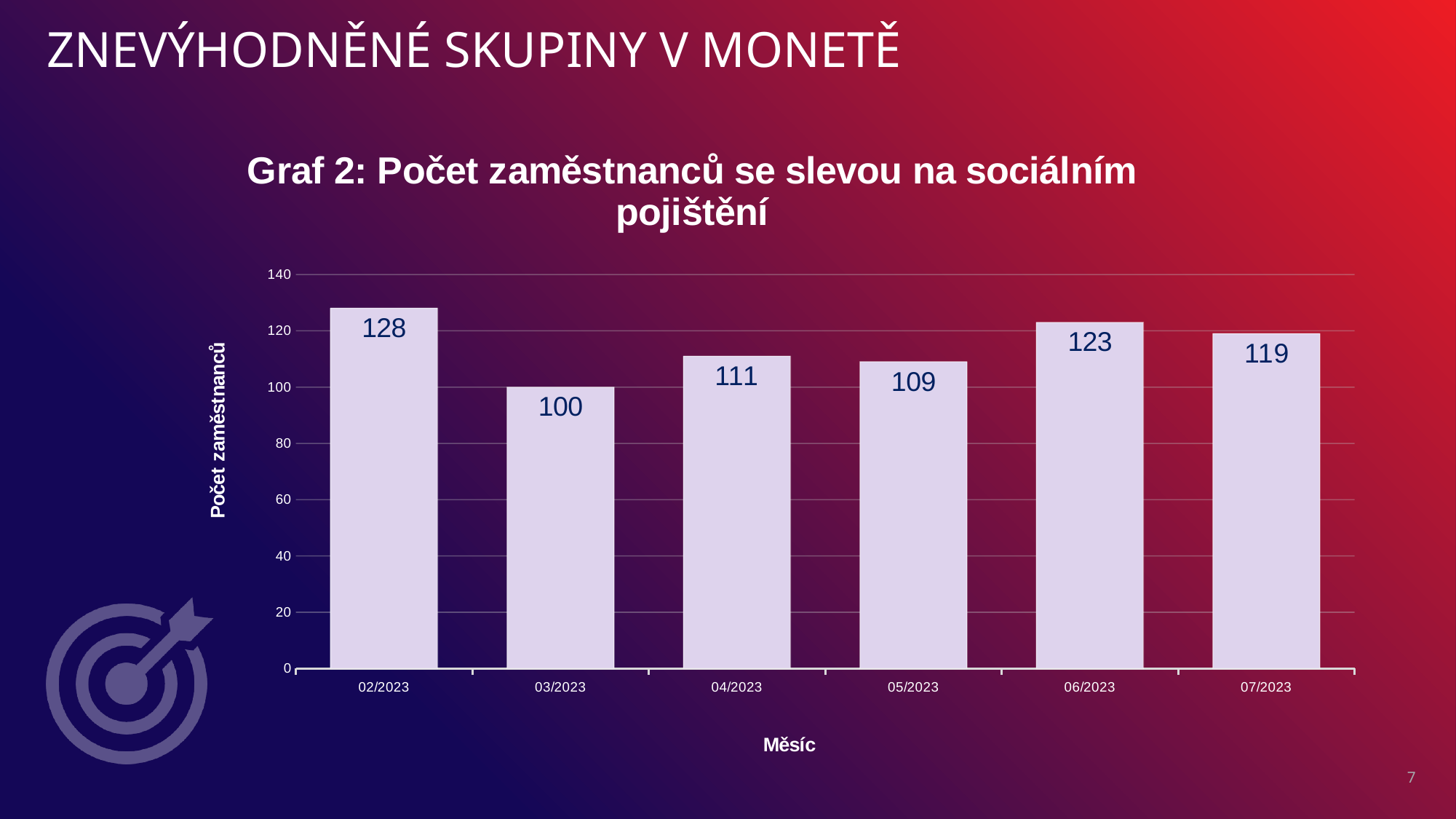
Which month has the lowest number of employees? 03/2023 How many months are shown on the x axis? 6 What is the value for 02/2023? 128 What kind of chart is shown on the slide? bar chart What is the title of the chart? Graf 2: Počet zaměstnanců se slevou na sociálním pojištění What is the value for 05/2023? 109 Is the value for 06/2023 greater or less than 120? greater Which is larger, the value for 04/2023 or the value for 05/2023? 04/2023 What is the value for 07/2023? 119 Which month has the highest number of employees? 02/2023 What is the difference between the values for 02/2023 and 03/2023? 28 What is the difference between the values for 06/2023 and 07/2023? 4